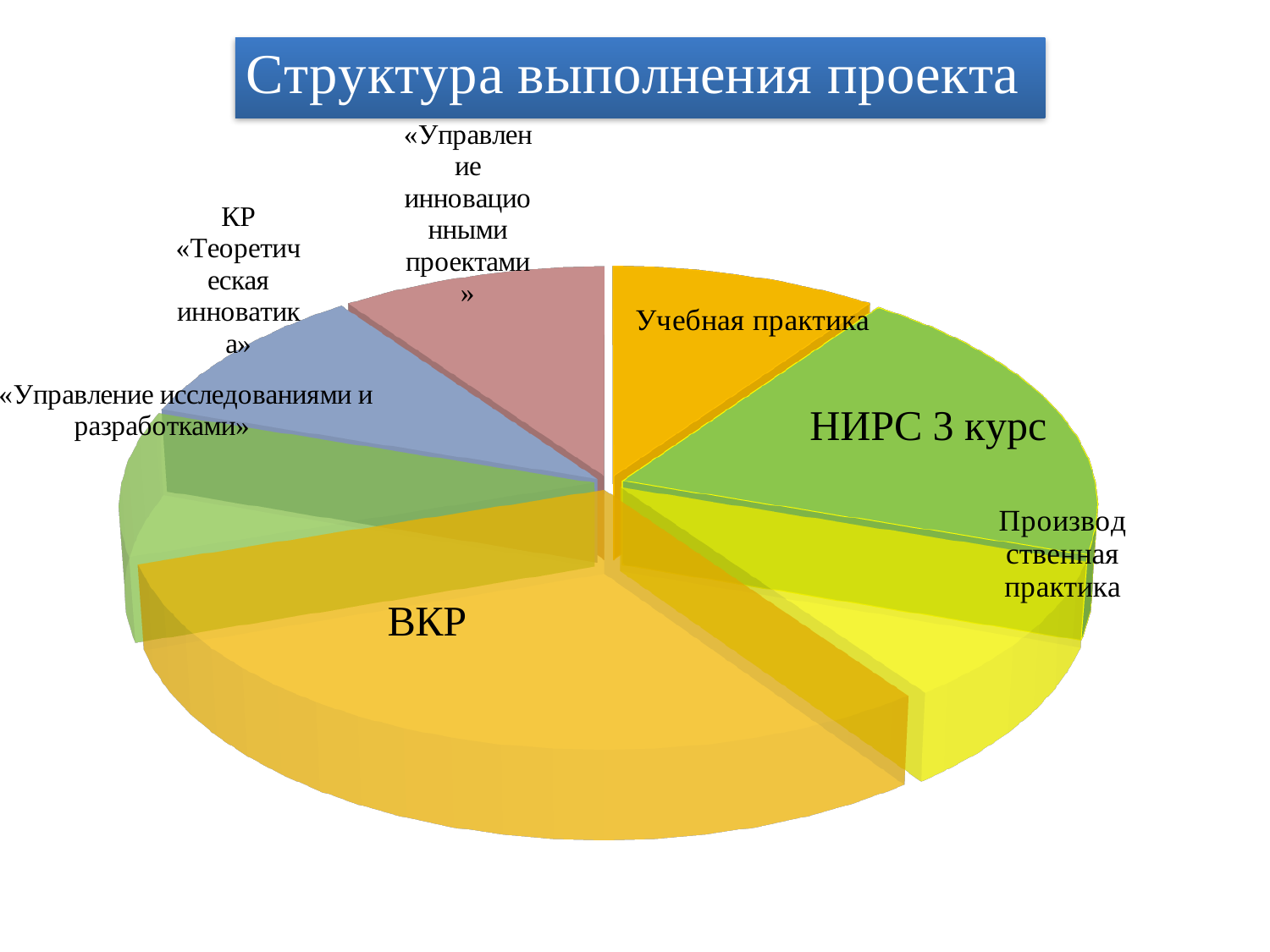
How many slices does the pie chart have? 7 What is the title of the slide with the pie chart? Структура выполнения проекта Which slice is larger, ВКР or НИРС 3 курс? ВКР Which slice is larger, ВКР or Учебная практика? ВКР Which slice is larger, НИРС 3 курс or Учебная практика? НИРС 3 курс Which slice of the pie chart is the largest? ВКР What kind of chart is shown on the slide? pie chart What colour is the ВКР slice of the pie chart? orange